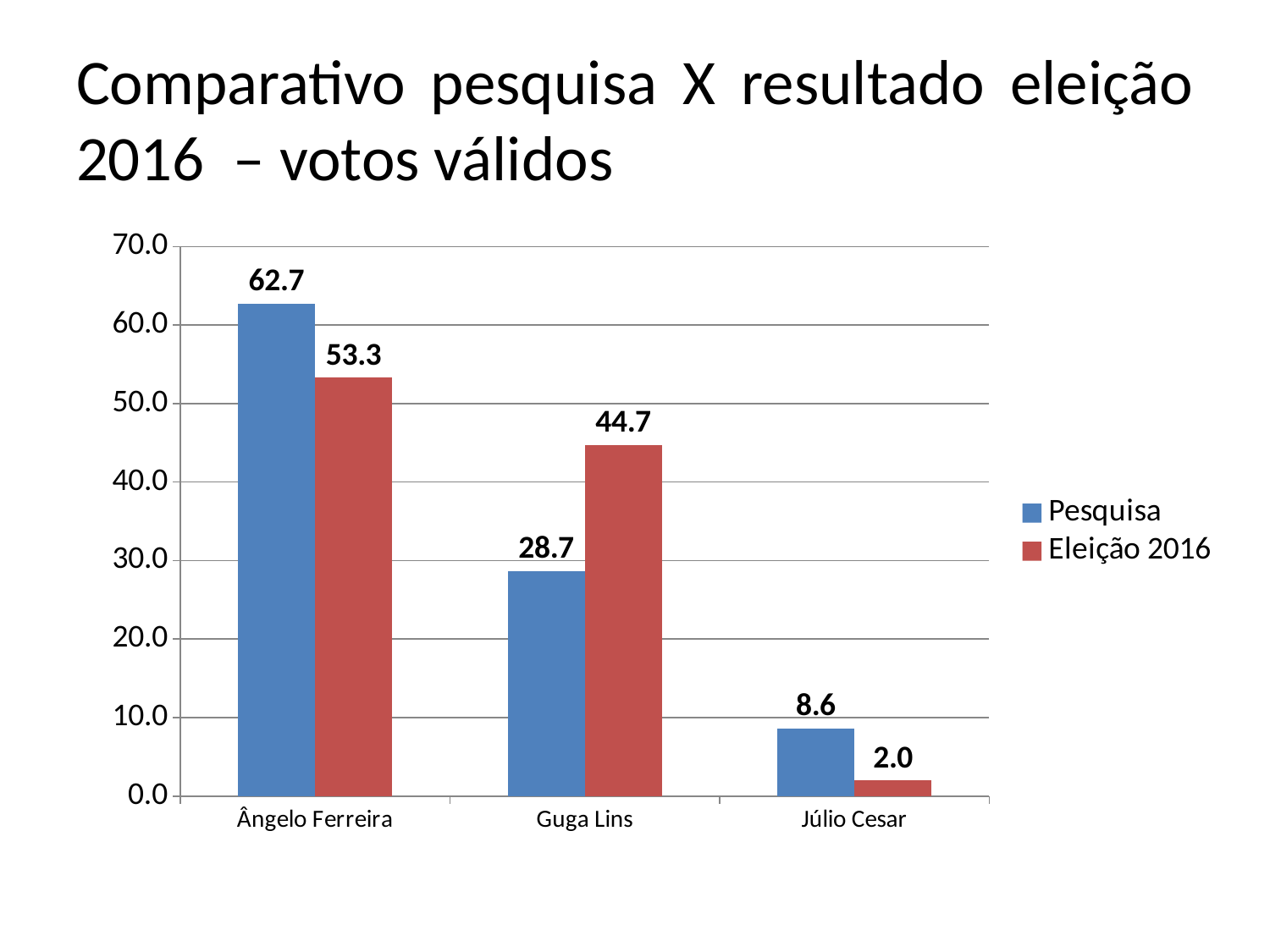
What is the difference between the Pesquisa and Eleição 2016 values for Guga Lins? 16.0 What is the Eleição 2016 value for Guga Lins? 44.7 How many candidates are shown on the x axis? 3 How many series does the legend list? 2 What is the Eleição 2016 value for Júlio Cesar? 2.0 What kind of chart is shown on the slide? Bar chart Which is larger for Júlio Cesar, the Pesquisa value or the Eleição 2016 value? Pesquisa Which candidate has the highest Pesquisa value? Ângelo Ferreira What is the difference between the Pesquisa and Eleição 2016 values for Ângelo Ferreira? 9.4 Which colour represents the Eleição 2016 series? Red What is the Pesquisa value for Ângelo Ferreira? 62.7 Which candidate has the lowest Eleição 2016 value? Júlio Cesar